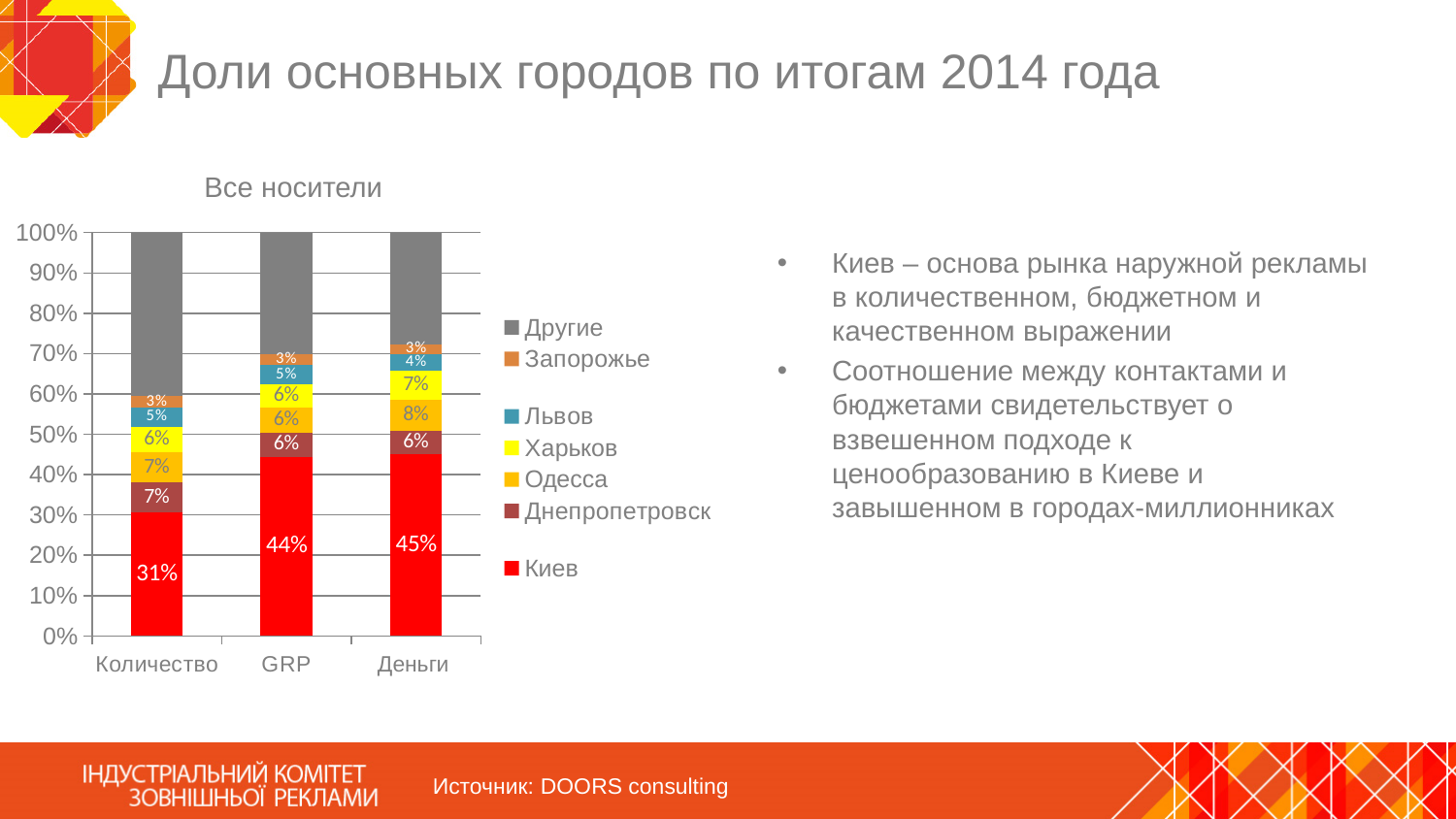
How many categories are shown on the x axis? 3 What is the value for Киев in the Деньги bar? 45% What kind of chart is shown on the slide? Stacked bar chart In which category is the Киев share highest? Деньги Is the value for Другие in the Количество bar greater or less than 30%? greater What is the difference between the Киев share in Деньги and in Количество? 14 percentage points How many series does the legend list? 7 What is the value for Одесса in the Деньги bar? 8% Which is larger: the Одесса share in Деньги or the Одесса share in GRP? Одесса in Деньги In which category is the Киев share lowest? Количество What is the value for Киев in the Количество bar? 31% What is the value for Днепропетровск in the Количество bar? 7%